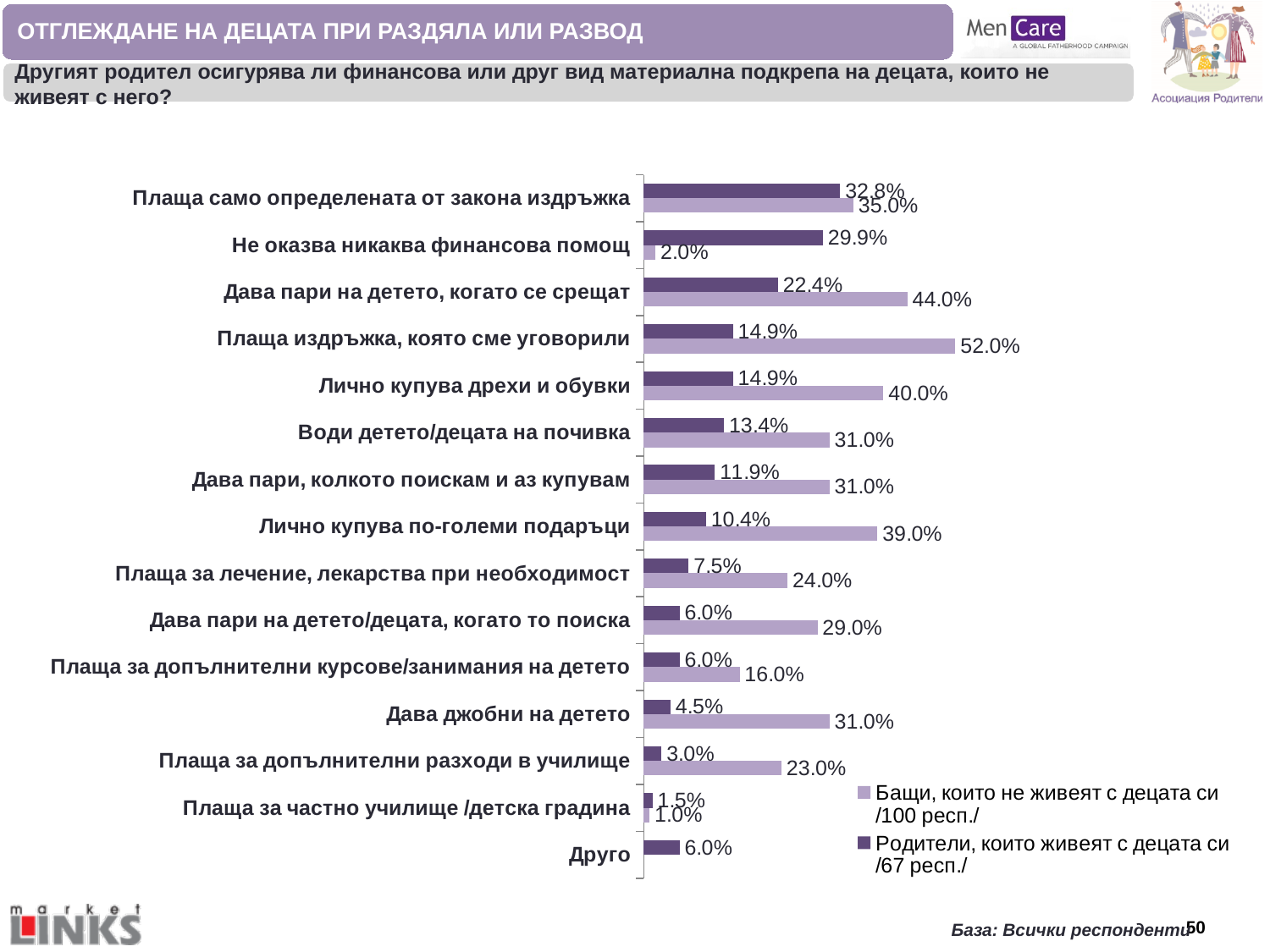
How many series does the legend list? 2 What is the value for "Не оказва никаква финансова помощ" in the series "Родители, които живеят с децата си /67 респ./"? 29.9% What is the value for "Дава джобни на детето" in the series "Бащи, които не живеят с децата си /100 респ./"? 31.0% Which category has the highest value in the series "Бащи, които не живеят с децата си /100 респ./"? Плаща издръжка, която сме уговорили How many categories are shown on the chart? 15 What is the value for "Друго" in the series "Родители, които живеят с децата си /67 респ./"? 6.0% Which category has the lowest value in the series "Родители, които живеят с децата си /67 респ./"? Плаща за частно училище /детска градина What type of chart is shown on the slide? bar chart What is the difference between the two series for "Дава пари на детето, когато се срещат"? 21.6% What is the value for "Плаща издръжка, която сме уговорили" in the series "Бащи, които не живеят с децата си /100 респ./"? 52.0% Which category has the highest value in the series "Родители, които живеят с децата си /67 респ./"? Плаща само определената от закона издръжка For "Не оказва никаква финансова помощ", which series has the larger value? Родители, които живеят с децата си /67 респ./